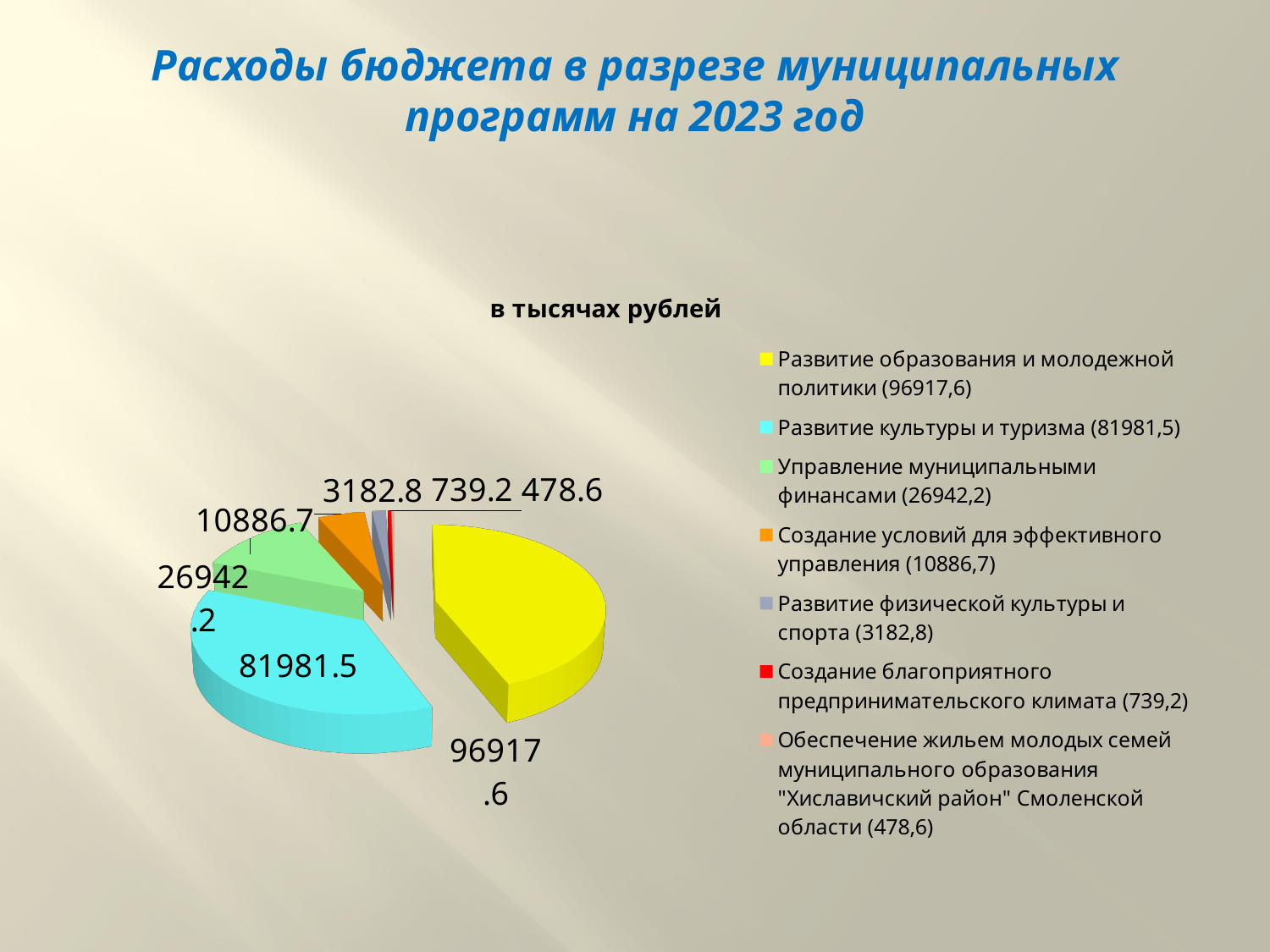
What is the value for Управление муниципальными финансами? 26942.2 How many slices does the pie chart have? 7 What is the difference between the values for Управление муниципальными финансами and Создание условий для эффективного управления? 16055.5 What unit is stated in the chart title above the pie? в тысячах рублей What is the difference between the values for Развитие образования и молодежной политики and Развитие культуры и туризма? 14936.1 What kind of chart is shown on the slide? pie chart Which program has the smallest slice of the pie? Обеспечение жильем молодых семей муниципального образования "Хиславичский район" Смоленской области What is the value for Развитие образования и молодежной политики? 96917.6 What is the value for Развитие культуры и туризма? 81981.5 Which is larger: the value for Создание благоприятного предпринимательского климата or the value for Развитие физической культуры и спорта? Развитие физической культуры и спорта Which program has the largest slice of the pie? Развитие образования и молодежной политики What is the value for Развитие физической культуры и спорта? 3182.8